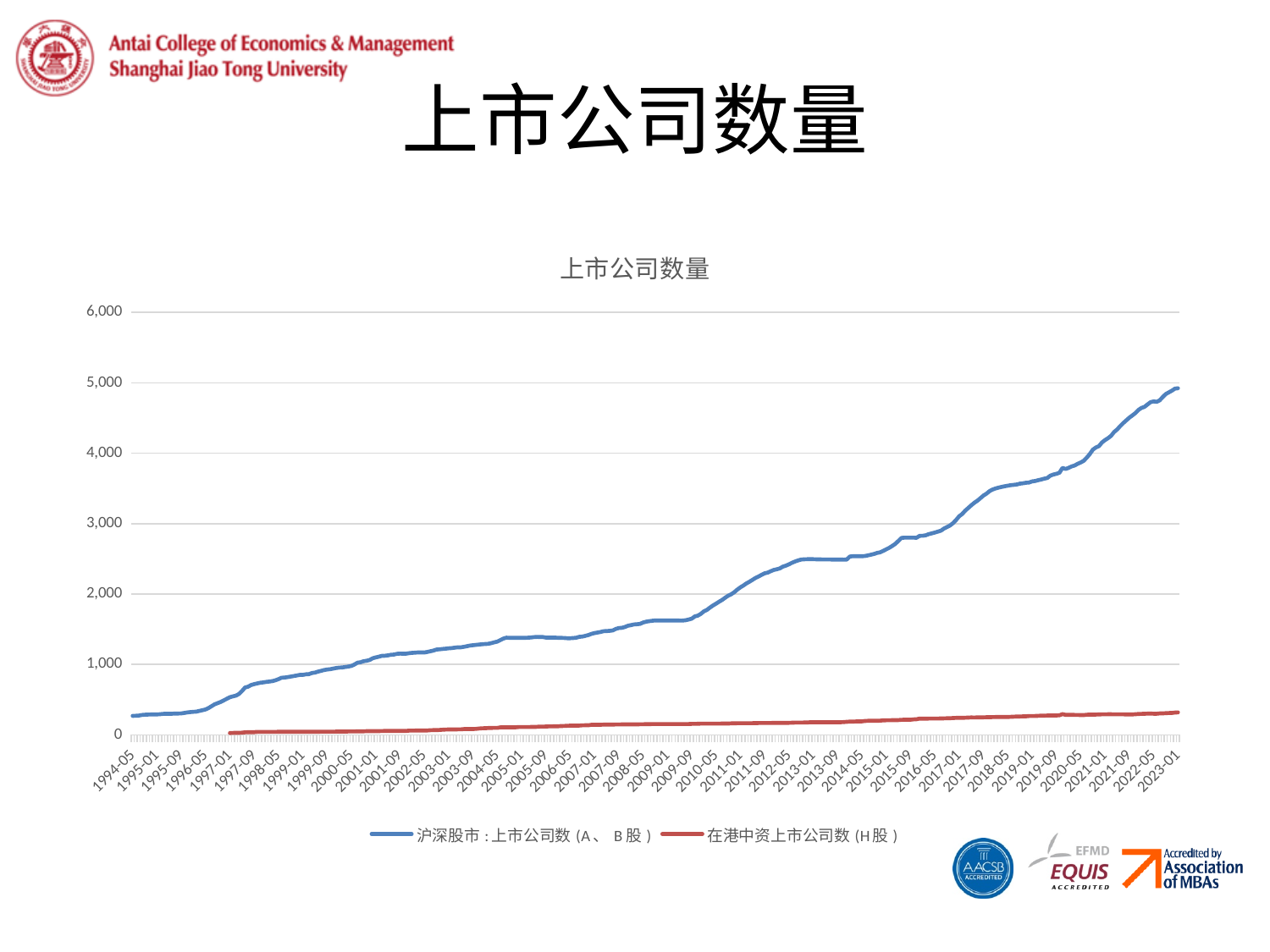
What kind of chart is shown on the slide? line chart Is the value for 沪深股市：上市公司数（A、B股） at 2017-09 greater or less than 3,000? greater Is the value for 在港中资上市公司数（H股） at 2023-01 greater or less than 1,000? less At 2023-01, which series has the larger value: 沪深股市：上市公司数（A、B股） or 在港中资上市公司数（H股）? 沪深股市：上市公司数（A、B股） Is the value for 沪深股市：上市公司数（A、B股） at 2013-01 greater or less than 2,000? greater Which series is drawn in red? 在港中资上市公司数（H股） Does the value for 沪深股市：上市公司数（A、B股） rise or fall from 1994-05 to 2023-01? rise How many series does the legend list? 2 What is the highest value shown on the vertical axis? 6,000 What is the title of the chart? 上市公司数量